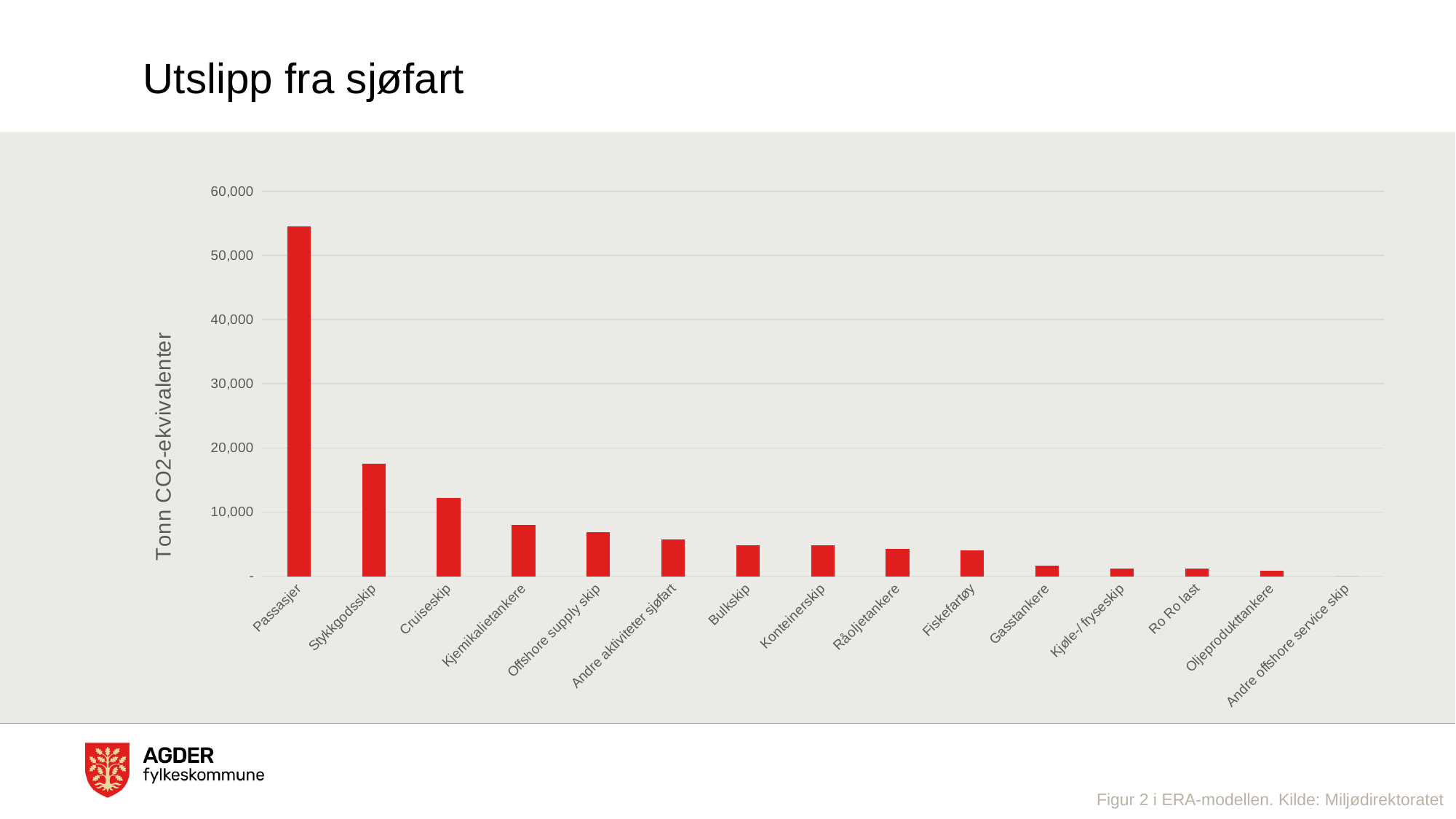
How many categories are shown on the x axis of the chart? 15 Which category has the lowest emissions in the chart? Andre offshore service skip What is the title of the y axis of the chart? Tonn CO2-ekvivalenter Is the value for Passasjer greater or less than 50,000? greater Which has a larger value, Gasstankere or Fiskefartøy? Fiskefartøy Which category has the highest emissions in the chart? Passasjer Is the value for Stykkgodsskip greater or less than 20,000? less Is the value for Cruiseskip greater or less than 10,000? greater Do the bar values rise or fall from left to right along the x axis? fall Which has a larger value, Stykkgodsskip or Cruiseskip? Stykkgodsskip What kind of chart is shown on the slide? bar chart